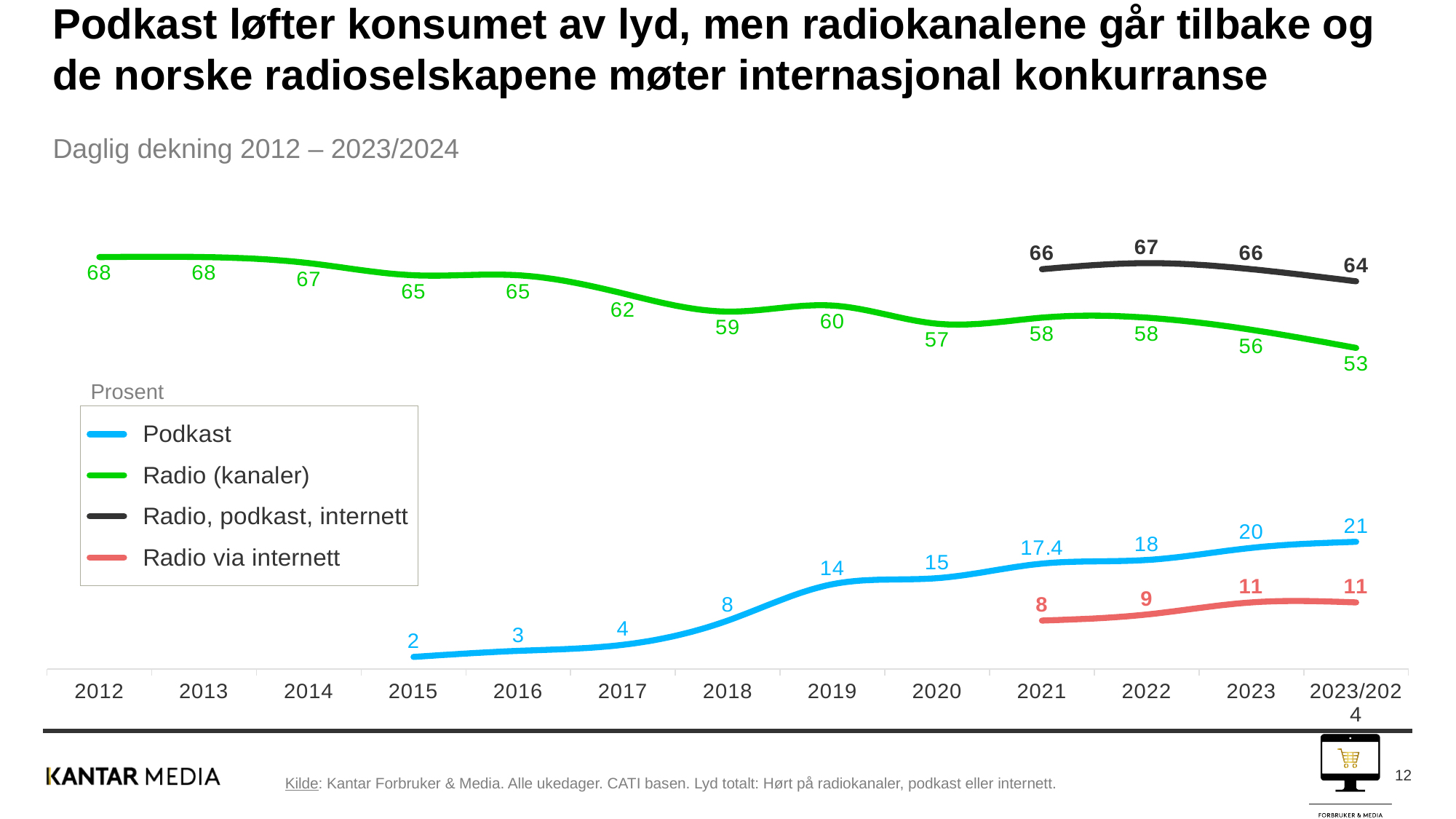
What is the value for Podkast in 2021? 17.4 In which year does the Podkast series reach its highest value? 2023/2024 Does the Podkast series rise or fall from 2015 to 2023/2024? Rises What is the value for Radio (kanaler) in 2012? 68 What is the difference between the Radio (kanaler) values in 2012 and 2023/2024? 15 In which year does the Radio (kanaler) series reach its lowest value? 2023/2024 What is the value for Radio via internett in 2023/2024? 11 What is the value for Radio, podkast, internett in 2022? 67 What kind of chart is shown on the slide? Line chart How many series does the legend list? 4 Which is larger in 2021: Radio, podkast, internett or Radio (kanaler)? Radio, podkast, internett How many x-axis categories (years) are shown on the chart? 13